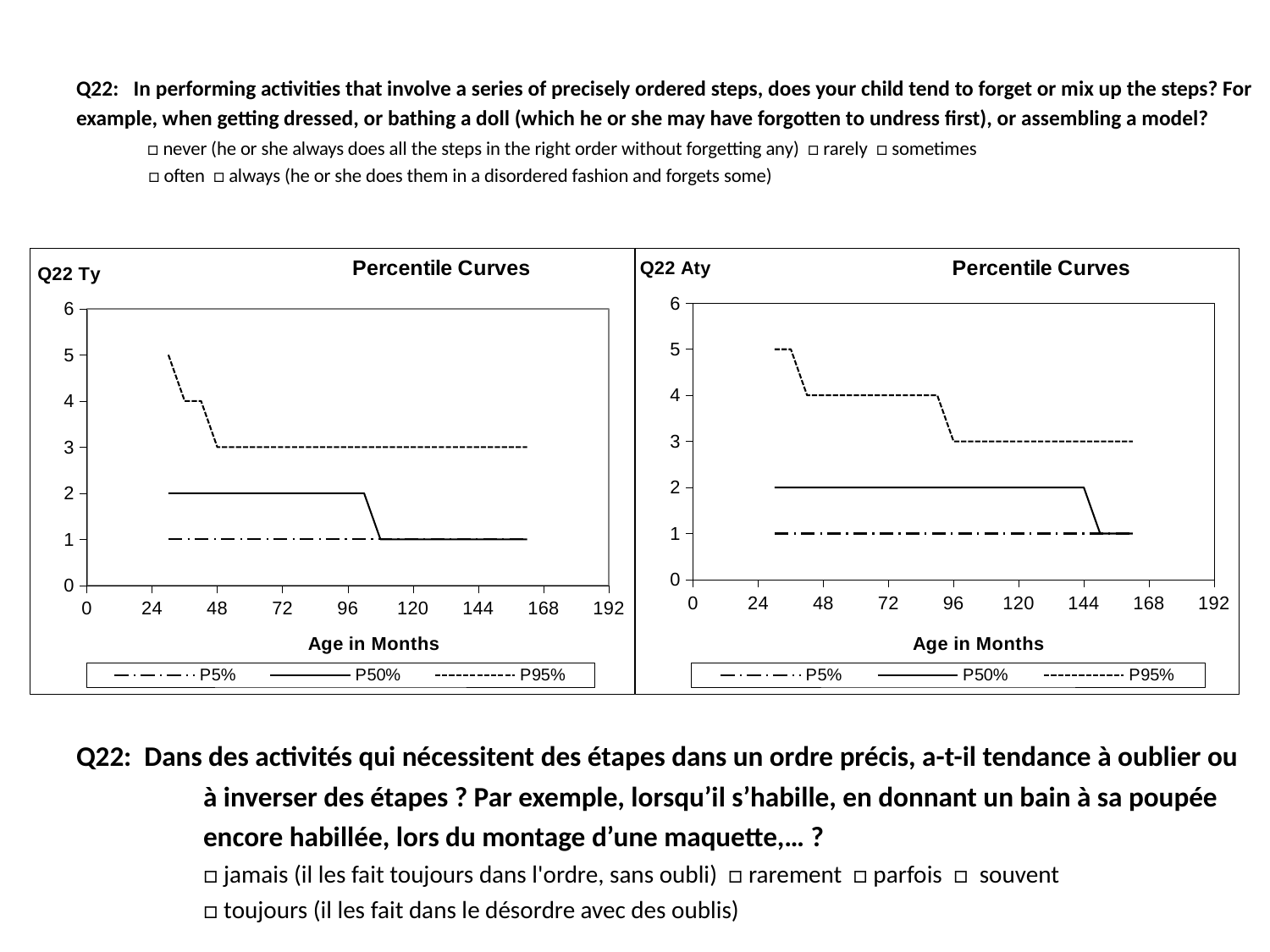
In the left chart (Q22 Ty), does the P95% curve rise or fall as age in months increases? fall What is the x-axis label of the right chart (Q22 Aty)? Age in Months In the right chart (Q22 Aty), what is the value of the P50% curve at 120 months? 2 In the left chart (Q22 Ty), what is the value of the P50% curve at 144 months? 1 In the right chart (Q22 Aty), what is the difference between the P95% and P5% curves at 72 months? 3 In the left chart (Q22 Ty), what is the value of the P95% curve at 120 months? 3 In the right chart (Q22 Aty), which curve is higher at 120 months, P50% or P95%? P95% In the right chart (Q22 Aty), what is the value of the P95% curve at 72 months? 4 How many series does the legend of the right chart (Q22 Aty) list? 3 What is the title of the left chart labelled Q22 Ty? Percentile Curves In the left chart (Q22 Ty), what is the difference between the P50% and P5% curves at 72 months? 1 What kind of chart is the left chart labelled Q22 Ty? line chart